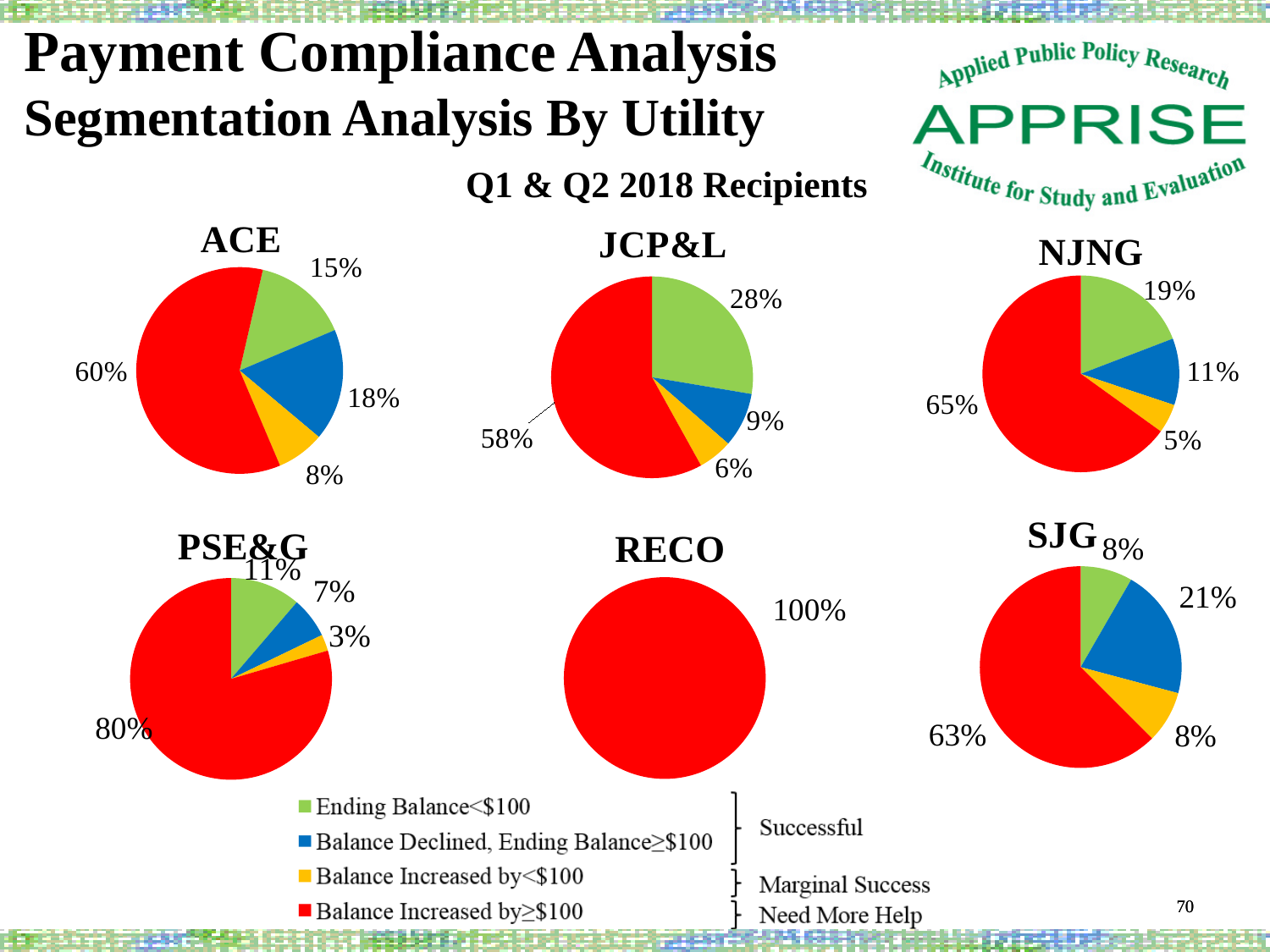
What is the difference between the Balance Increased by≥$100 share in PSE&G (80%) and in ACE (60%)? 20% In the JCP&L pie chart, what share is Ending Balance<$100 (green)? 28% In the NJNG pie chart, what share is Balance Increased by<$100 (yellow)? 5% What kind of charts are shown on the slide? Pie charts Which is larger: the Ending Balance<$100 share in JCP&L or in NJNG? JCP&L In the RECO pie chart, what share is Balance Increased by≥$100 (red)? 100% How many categories does the legend list? 4 How many pie charts are on the slide? 6 In the PSE&G pie chart, which category has the smallest share? Balance Increased by<$100 In the SJG pie chart, which category has the largest share? Balance Increased by≥$100